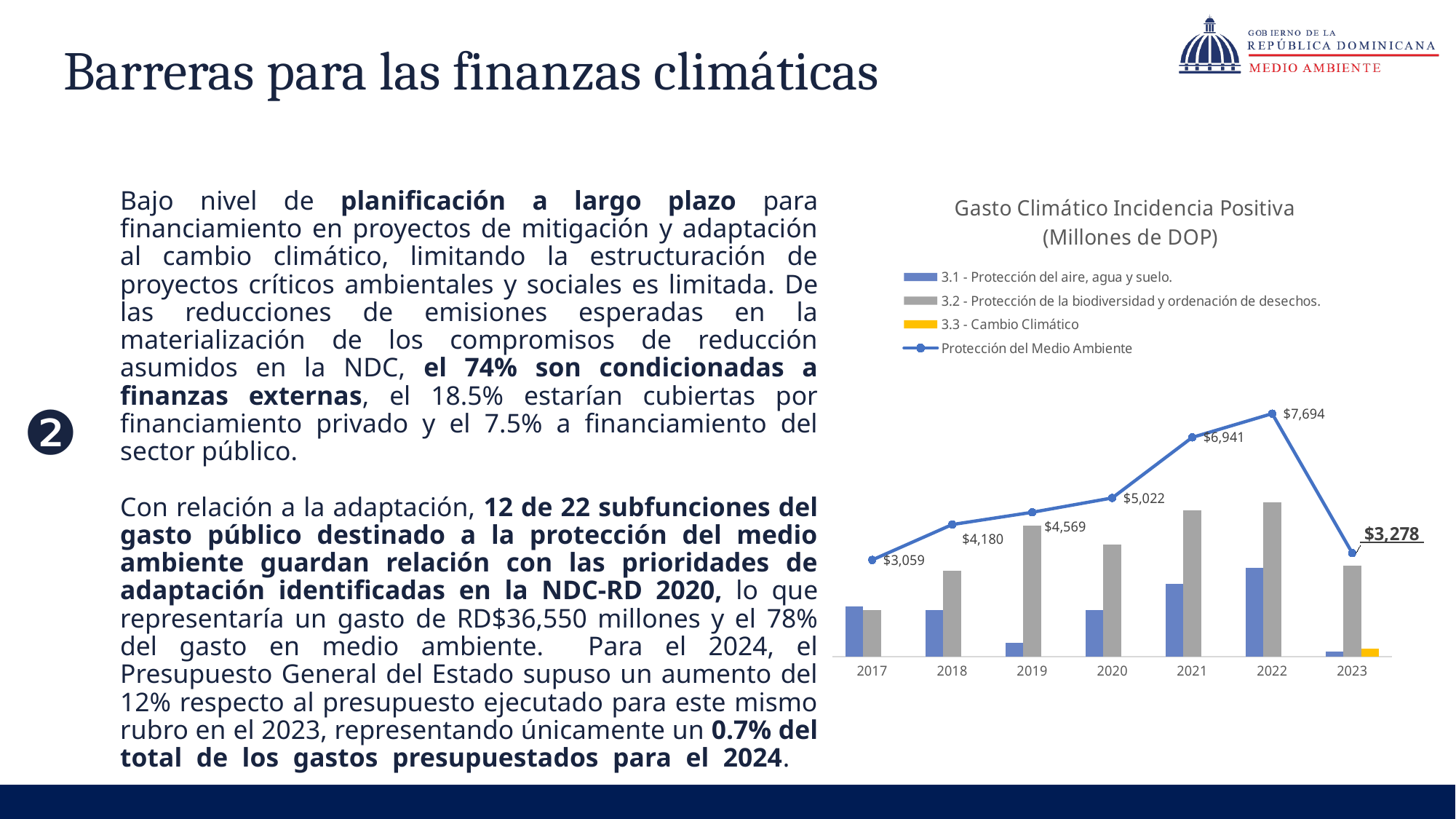
What is the difference between the Protección del Medio Ambiente values for 2018 and 2017? $1,121 In which year does the Protección del Medio Ambiente line have its lowest value? 2017 How many years are shown on the x axis of the chart? 7 What is the value of the Protección del Medio Ambiente line for 2017? $3,059 In which year does the Protección del Medio Ambiente line reach its highest value? 2022 What is the value of the Protección del Medio Ambiente line for 2023? $3,278 What is the difference between the Protección del Medio Ambiente values for 2022 and 2021? $753 Which year has a higher Protección del Medio Ambiente value, 2019 or 2020? 2020 How many series does the chart legend list? 4 What is the value of the Protección del Medio Ambiente line for 2022? $7,694 Does the Protección del Medio Ambiente line rise or fall from 2017 to 2022? rise In 2022, which bar is taller: 3.1 - Protección del aire, agua y suelo or 3.2 - Protección de la biodiversidad y ordenación de desechos? 3.2 - Protección de la biodiversidad y ordenación de desechos